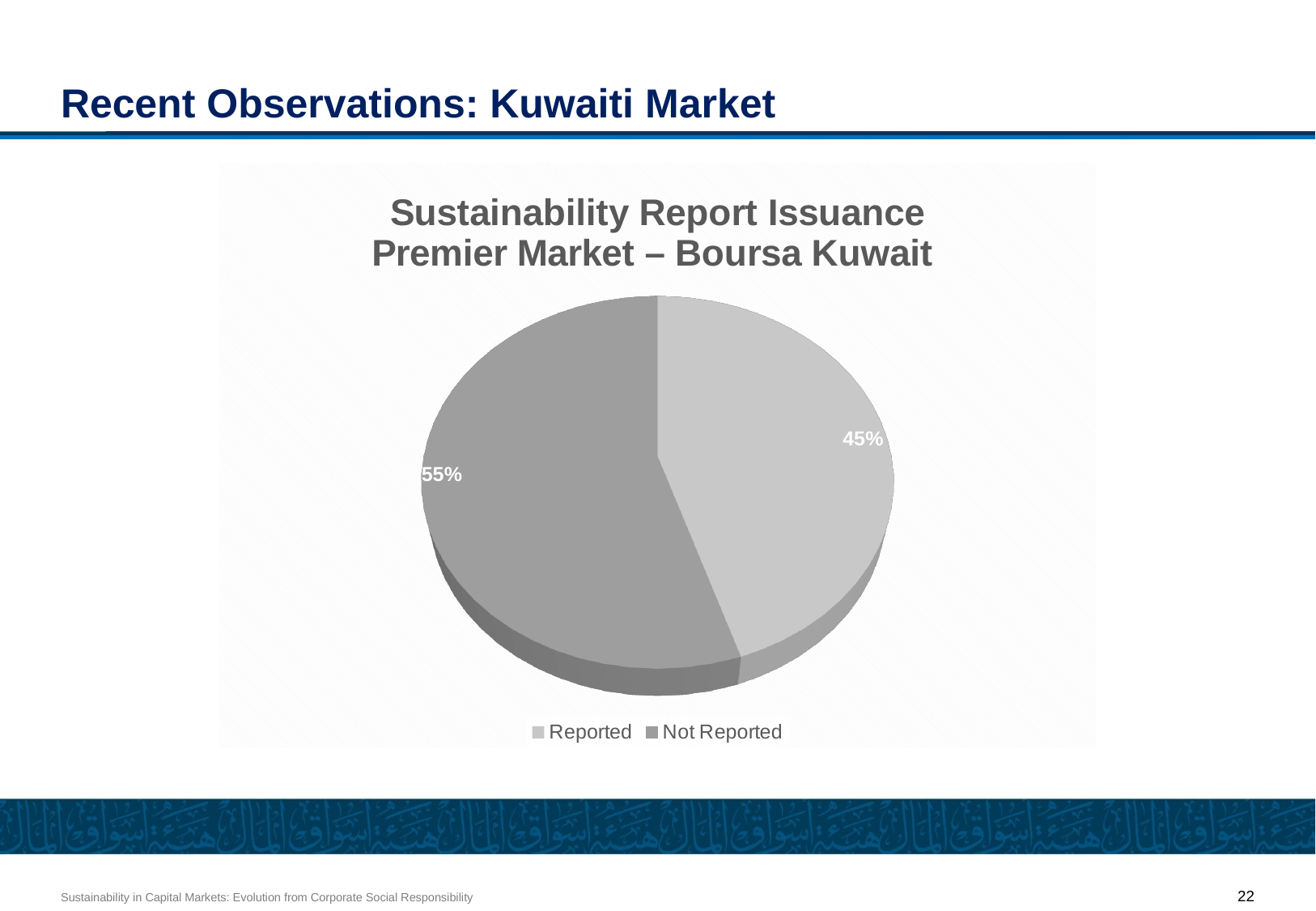
What share of the pie is labelled Reported? 45% Is the value for Reported greater or less than 50%? less Which slice is the largest? Not Reported What is the difference in percentage points between the Not Reported and Reported slices? 10 How many slices does the pie chart have? 2 What kind of chart is shown on the slide? pie chart Which legend entry is shown in the darker grey? Not Reported Which slice is the smallest? Reported Which is larger, the Reported slice or the Not Reported slice? Not Reported How many entries does the legend list? 2 What share of the pie is labelled Not Reported? 55% What is the title of the chart? Sustainability Report Issuance Premier Market – Boursa Kuwait